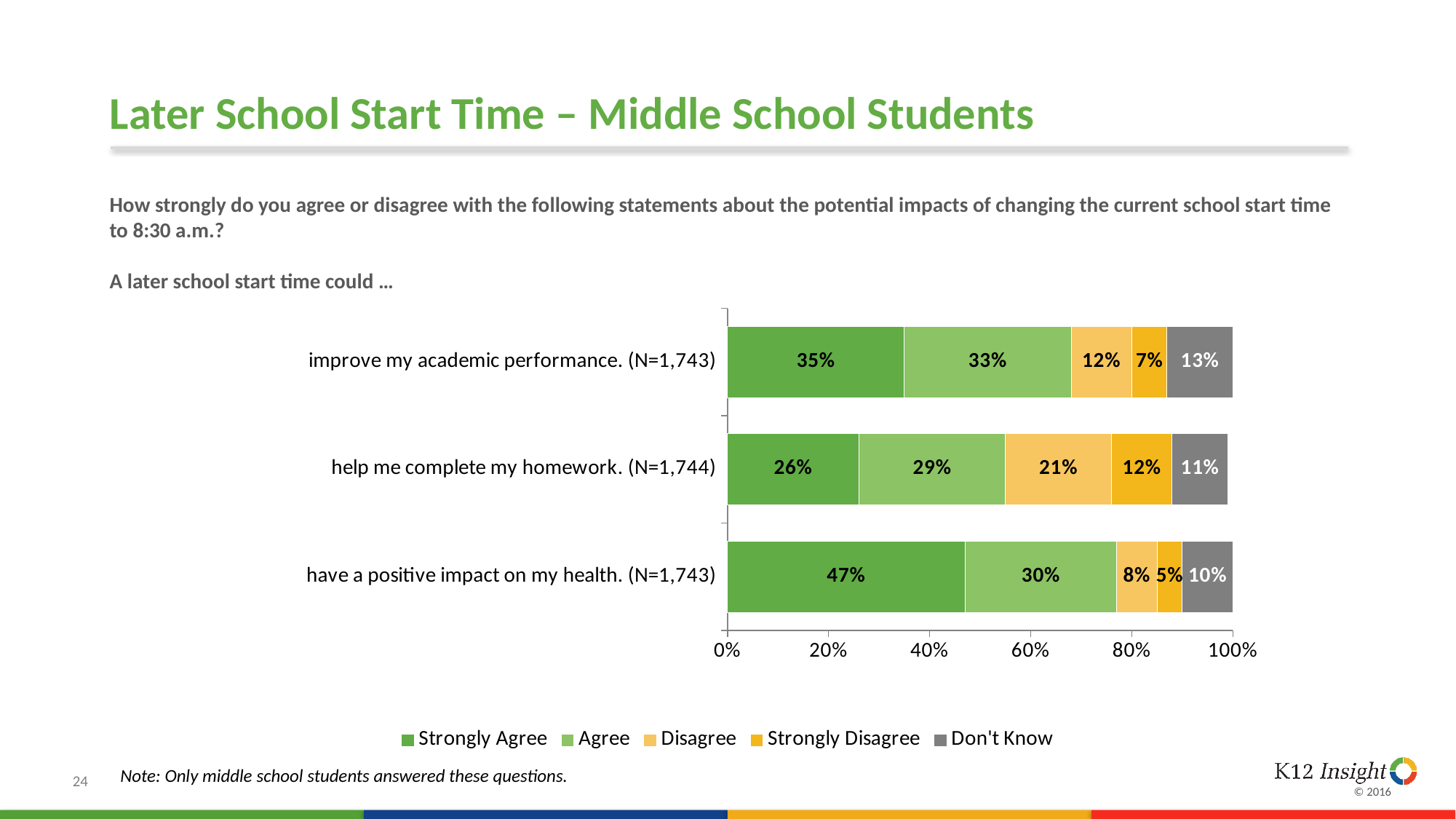
Which statement has the highest Strongly Agree percentage? have a positive impact on my health Which statement has a larger Agree percentage: 'improve my academic performance' or 'help me complete my homework'? improve my academic performance How many statements are shown in the chart? 3 Which statement has the lowest Strongly Agree percentage? help me complete my homework How much higher is the Strongly Agree percentage for 'have a positive impact on my health' than for 'improve my academic performance'? 12% What kind of chart is shown on the slide? stacked bar chart What is the Don't Know percentage for the statement 'have a positive impact on my health'? 10% What is the combined Strongly Agree and Agree percentage for 'improve my academic performance'? 68% What is the Strongly Disagree percentage for the statement 'help me complete my homework'? 12% How many response categories does the legend list? 5 What percentage of middle school students strongly agree that a later school start time could improve their academic performance? 35% What percentage of students disagree that a later school start time could help them complete their homework? 21%